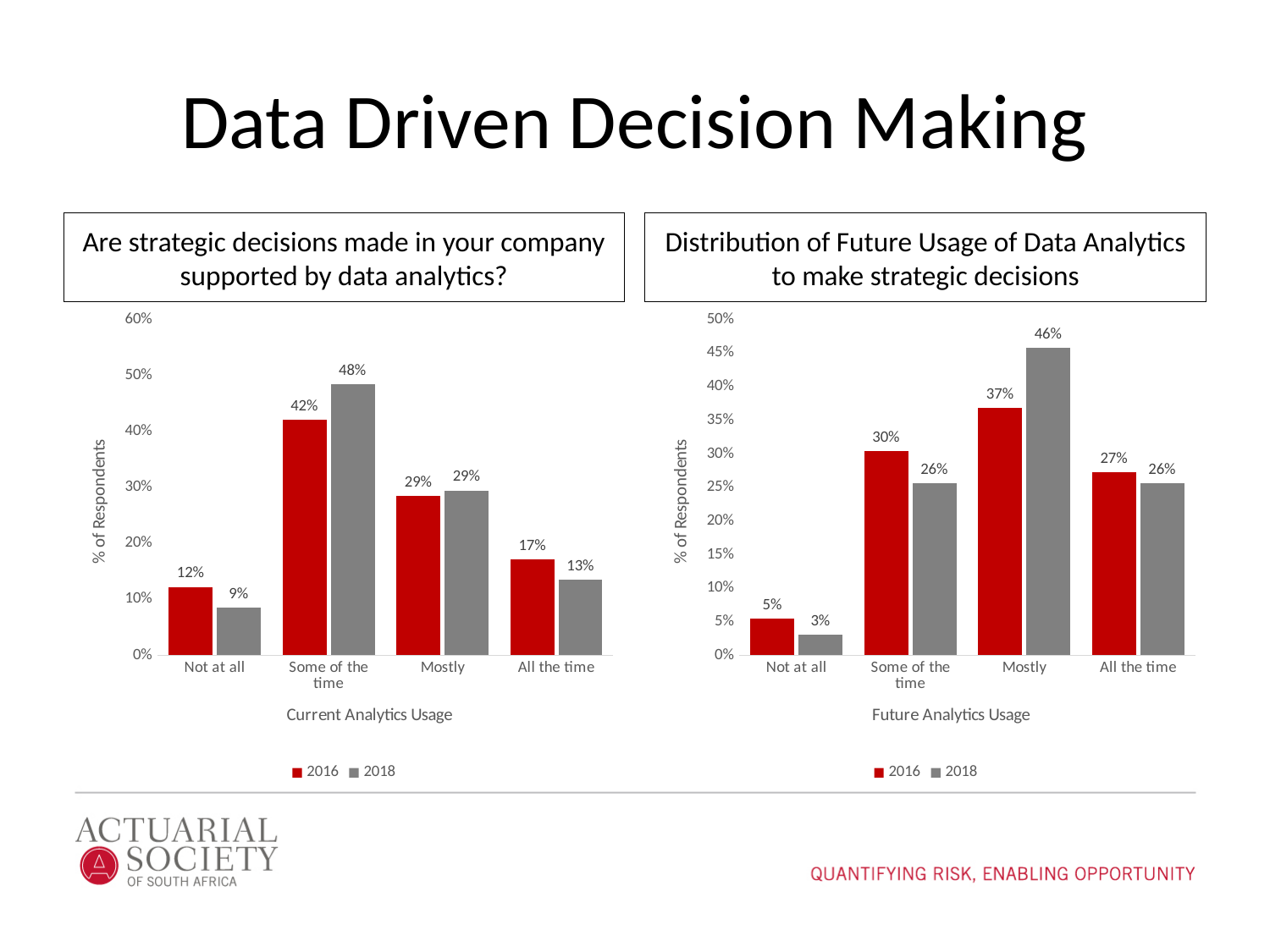
In the right chart (Future Analytics Usage), which is larger for 'Some of the time': the 2016 value or the 2018 value? 2016 In the right chart (Future Analytics Usage), what is the 2018 value for 'Mostly'? 46% In the right chart (Future Analytics Usage), what is the difference between the 2018 and 2016 values for 'Mostly'? 9% In the left chart (Current Analytics Usage), what is the difference between the 2016 and 2018 values for 'All the time'? 4% How many categories are shown on the x axis of the left chart (Current Analytics Usage)? 4 What type of chart is the left chart (Current Analytics Usage)? Bar chart In the left chart (Current Analytics Usage), what is the 2016 value for 'Not at all'? 12% In the left chart (Current Analytics Usage), which category has the highest 2016 value? Some of the time How many series does the legend of the right chart (Future Analytics Usage) list? 2 In the right chart (Future Analytics Usage), what is the 2016 value for 'All the time'? 27% In the left chart (Current Analytics Usage), what is the 2018 value for 'Some of the time'? 48% In the right chart (Future Analytics Usage), which category has the lowest 2018 value? Not at all